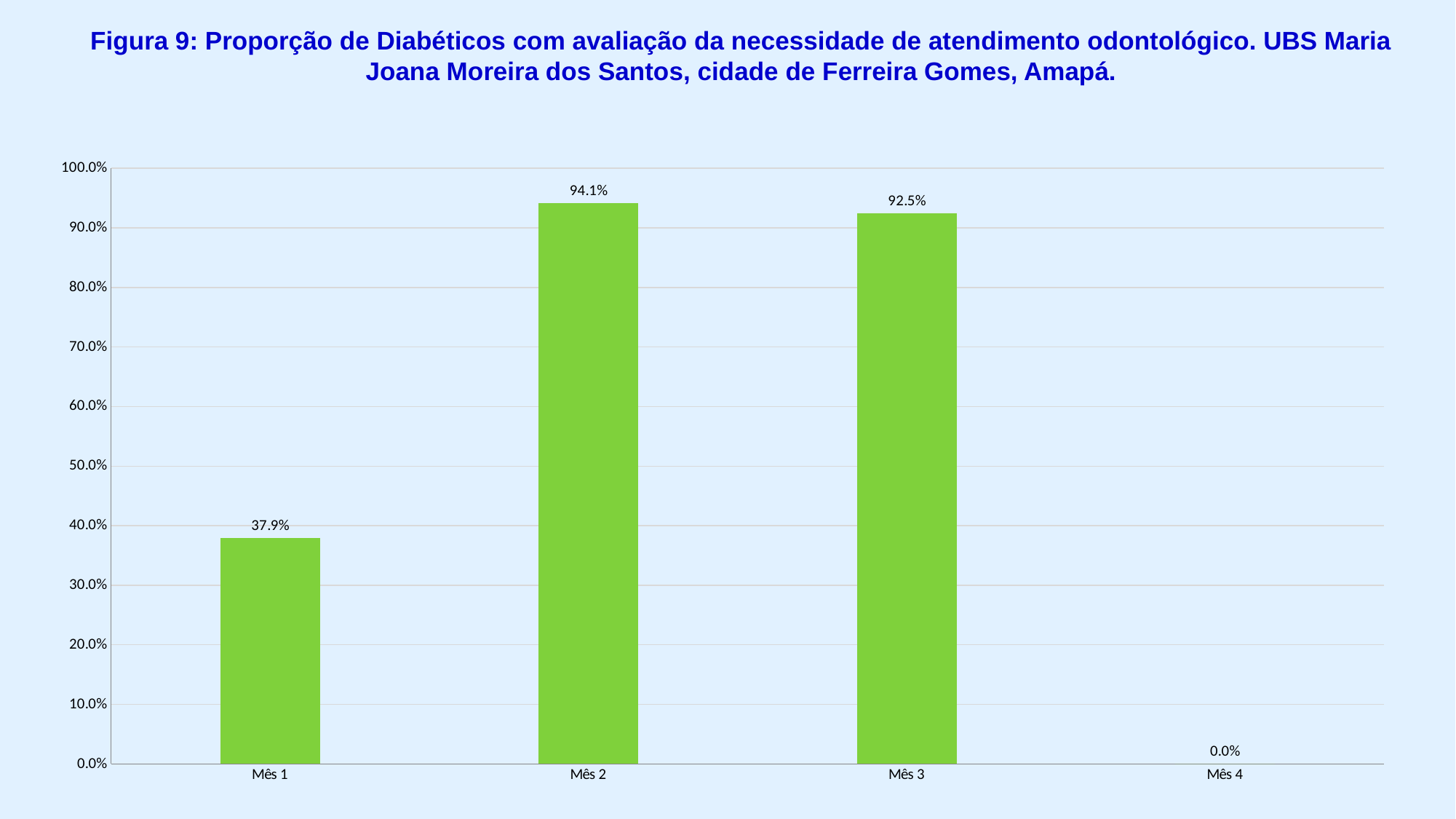
Which month has the highest value? Mês 2 Which month has the lowest value? Mês 4 Is the value for Mês 1 greater or less than 40.0%? less How many months are shown on the x axis? 4 Which is larger, the value for Mês 1 or the value for Mês 3? Mês 3 What kind of chart is shown on the slide? bar chart What colour are the bars in the chart? green What is the value for Mês 4? 0.0% What is the difference between the values for Mês 2 and Mês 1? 56.2% What is the value for Mês 1? 37.9% What is the value for Mês 3? 92.5% What is the value for Mês 2? 94.1%